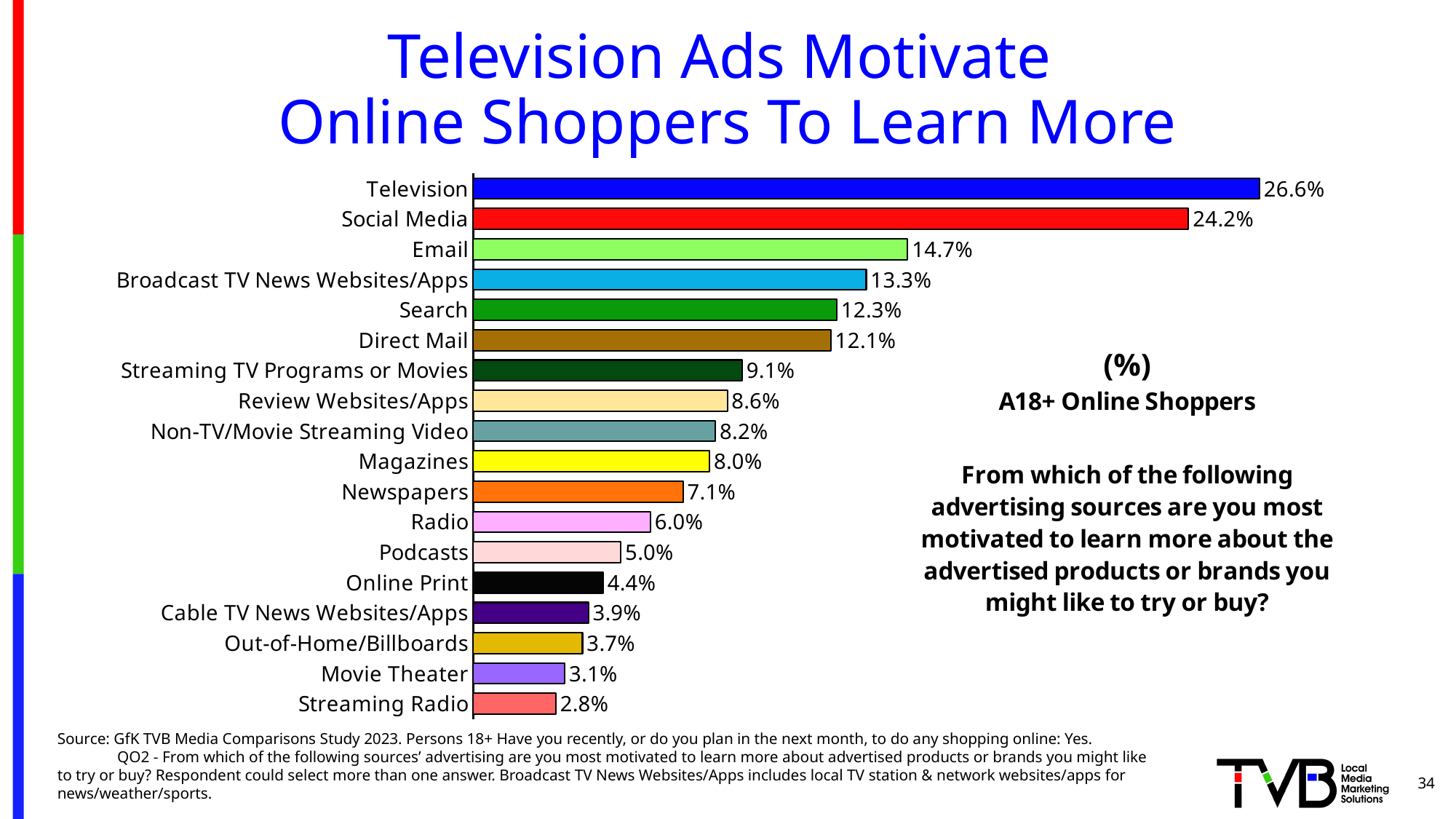
Which is larger, the value for Magazines or the value for Newspapers? Magazines What is the value for Direct Mail? 12.1% How many categories are shown in the chart? 18 Which category has the highest value? Television What is the difference between the values for Email and Search? 2.4% Which is larger, the value for Radio or the value for Review Websites/Apps? Review Websites/Apps What kind of chart is shown on the slide? Bar chart What is the value for Television? 26.6% Which category has the lowest value? Streaming Radio What is the difference between the values for Television and Social Media? 2.4% What is the value for Cable TV News Websites/Apps? 3.9% What is the value for Podcasts? 5.0%